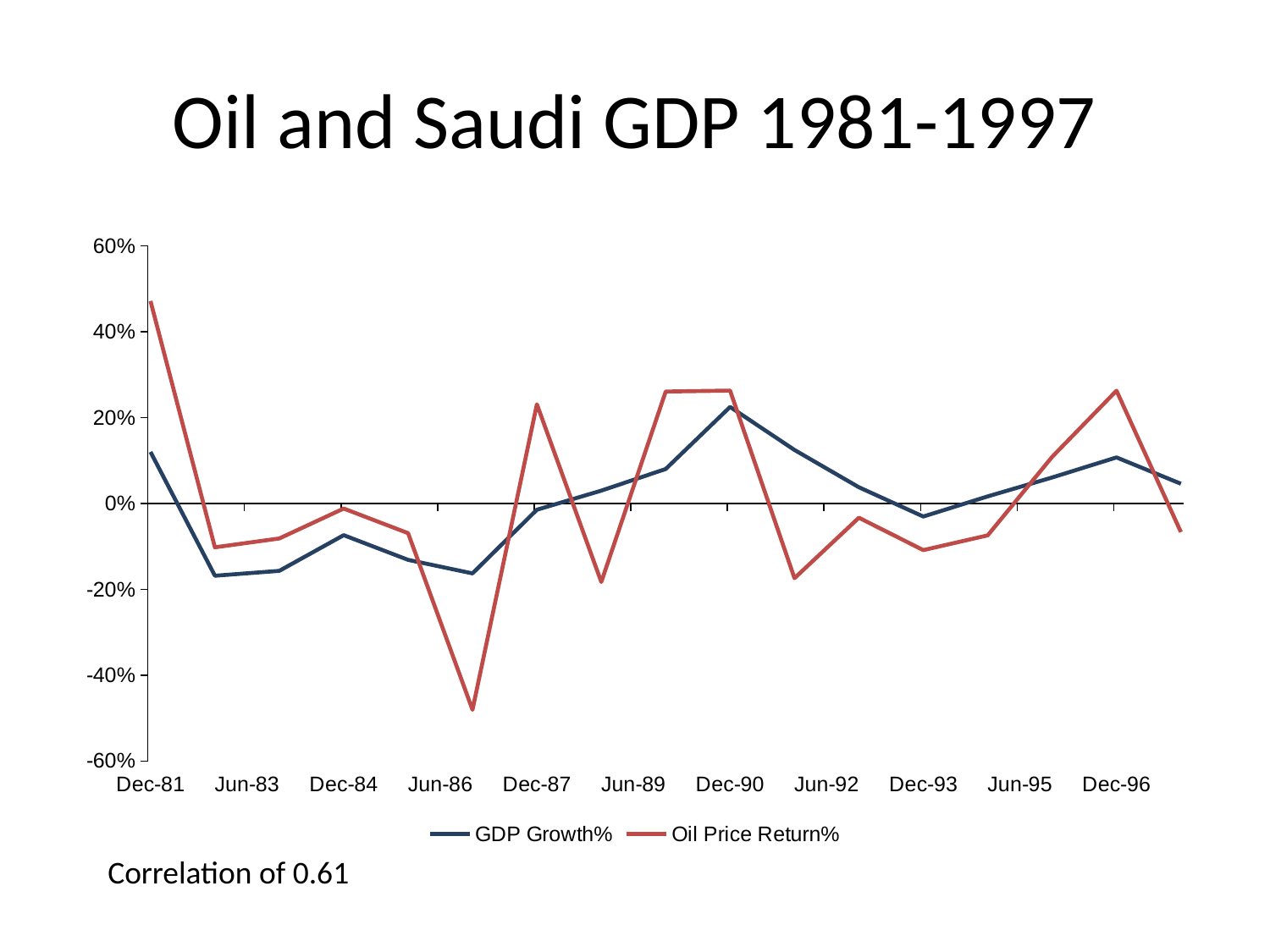
Is the value for Oil Price Return% at Jun-92 greater or less than 0%? less What is the title of the chart? Oil and Saudi GDP 1981-1997 How many series does the legend list? 2 Does GDP Growth% rise or fall from Dec-81 to Jun-83? fall Which series reaches the lowest value on the chart? Oil Price Return% Is the value for Oil Price Return% at Dec-81 greater or less than 40%? greater Which series reaches the highest value on the chart? Oil Price Return% Is the value for GDP Growth% at Dec-81 greater or less than 0%? greater What kind of chart is shown on the slide? Line chart At Dec-81, which series has the higher value, GDP Growth% or Oil Price Return%? Oil Price Return% Which series is drawn in red? Oil Price Return%